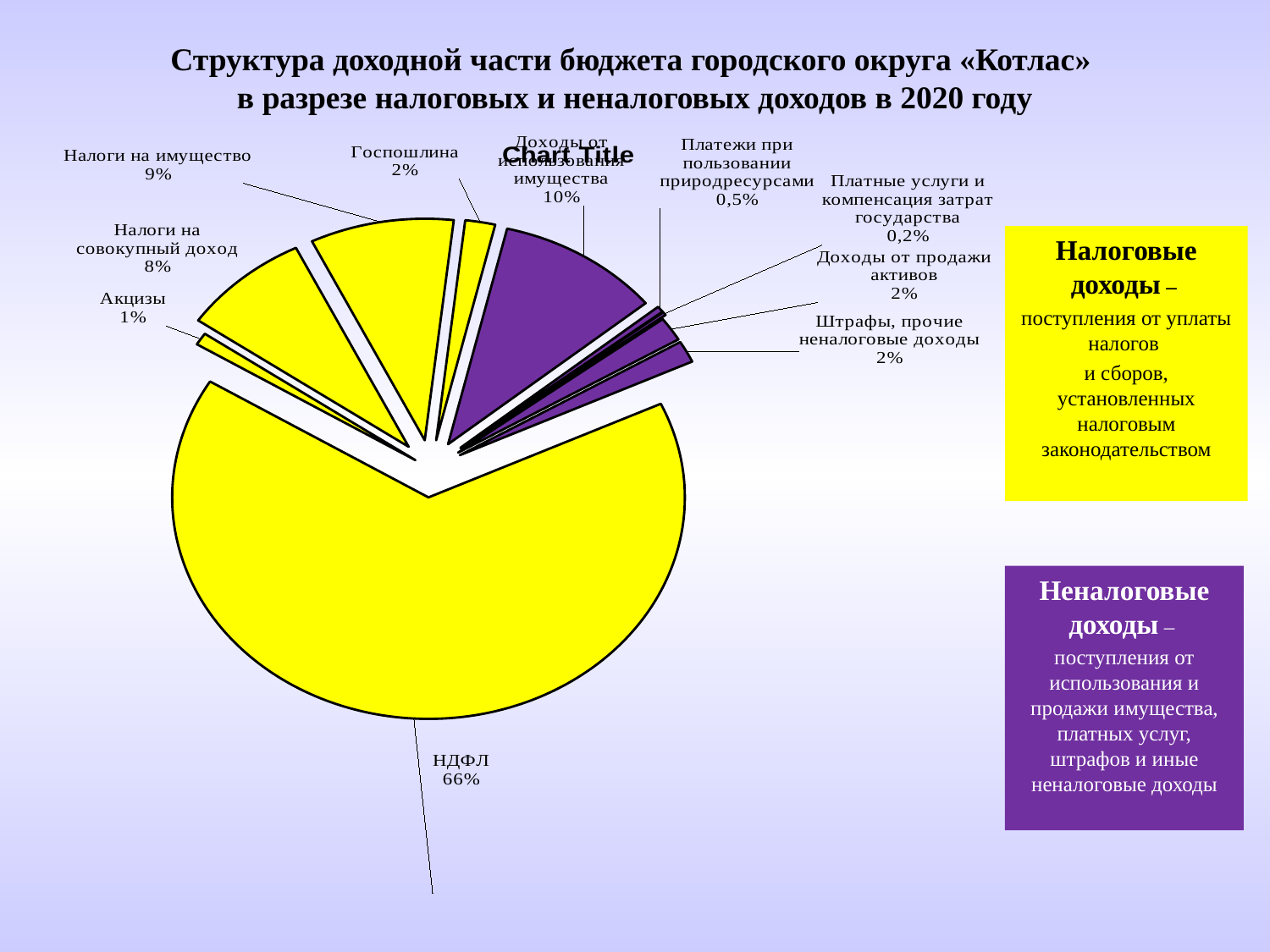
Which category has the smallest slice of the pie? Платные услуги и компенсация затрат государства Which is larger, the share of Налоги на имущество or the share of Налоги на совокупный доход? Налоги на имущество What is the value shown for Платежи при пользовании природресурсами? 0,5% What is the value shown for Доходы от использования имущества? 10% What is the difference between the shares of НДФЛ and Доходы от использования имущества? 56% Which category has the largest slice of the pie? НДФЛ What is the combined share of Налоги на совокупный доход and Акцизы? 9% What share of the pie does НДФЛ have? 66% What colour are the slices representing non-tax revenues (неналоговые доходы) in the pie chart? purple What is the value shown for Налоги на имущество? 9% How many slices does the pie chart have? 10 What kind of chart is shown on the slide? pie chart